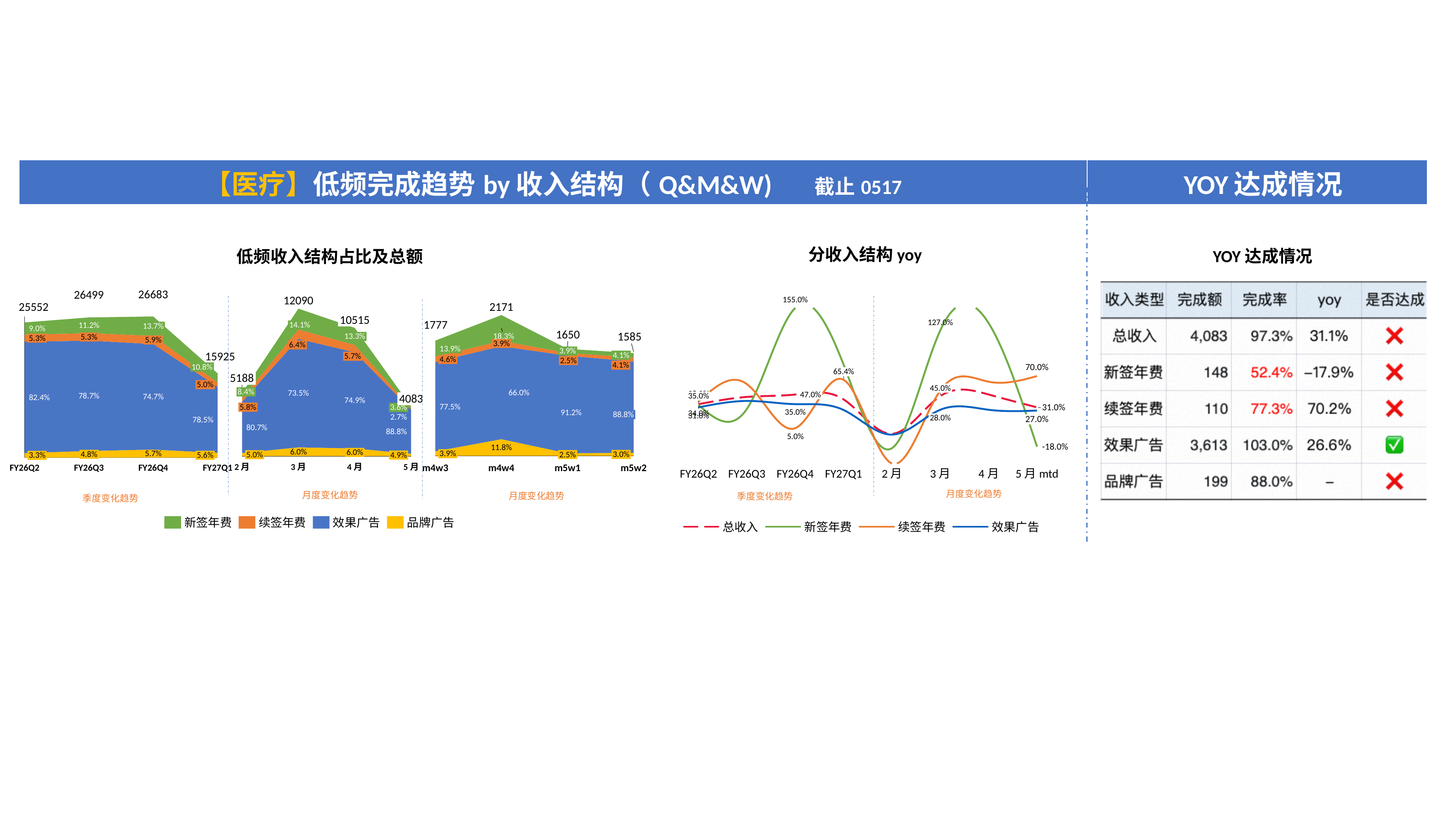
In the chart '低频收入结构占比及总额', what is the difference between the totals for FY26Q3 and FY26Q2? 947 In the chart '低频收入结构占比及总额', what share does 效果广告 have in FY26Q2? 82.4% In the chart '分收入结构 yoy', what is the 续签年费 yoy value labelled at 5月 mtd? 70.0% What kind of chart is '分收入结构 yoy'? line chart In the chart '低频收入结构占比及总额', which week in the weekly panel has the lowest printed total? m5w2 How many series does the legend of the chart '低频收入结构占比及总额' list? 4 In the chart '低频收入结构占比及总额', is the 新签年费 share larger in m4w4 or in m5w1? m4w4 In the chart '低频收入结构占比及总额', which quarter has the highest printed total? FY26Q4 In the chart '低频收入结构占比及总额', what is the total printed above FY26Q4? 26683 In the chart '低频收入结构占比及总额', what is the total printed for 3月 in the monthly panel? 12090 In the chart '分收入结构 yoy', does the 新签年费 line rise or fall from 3月 to 5月 mtd? fall